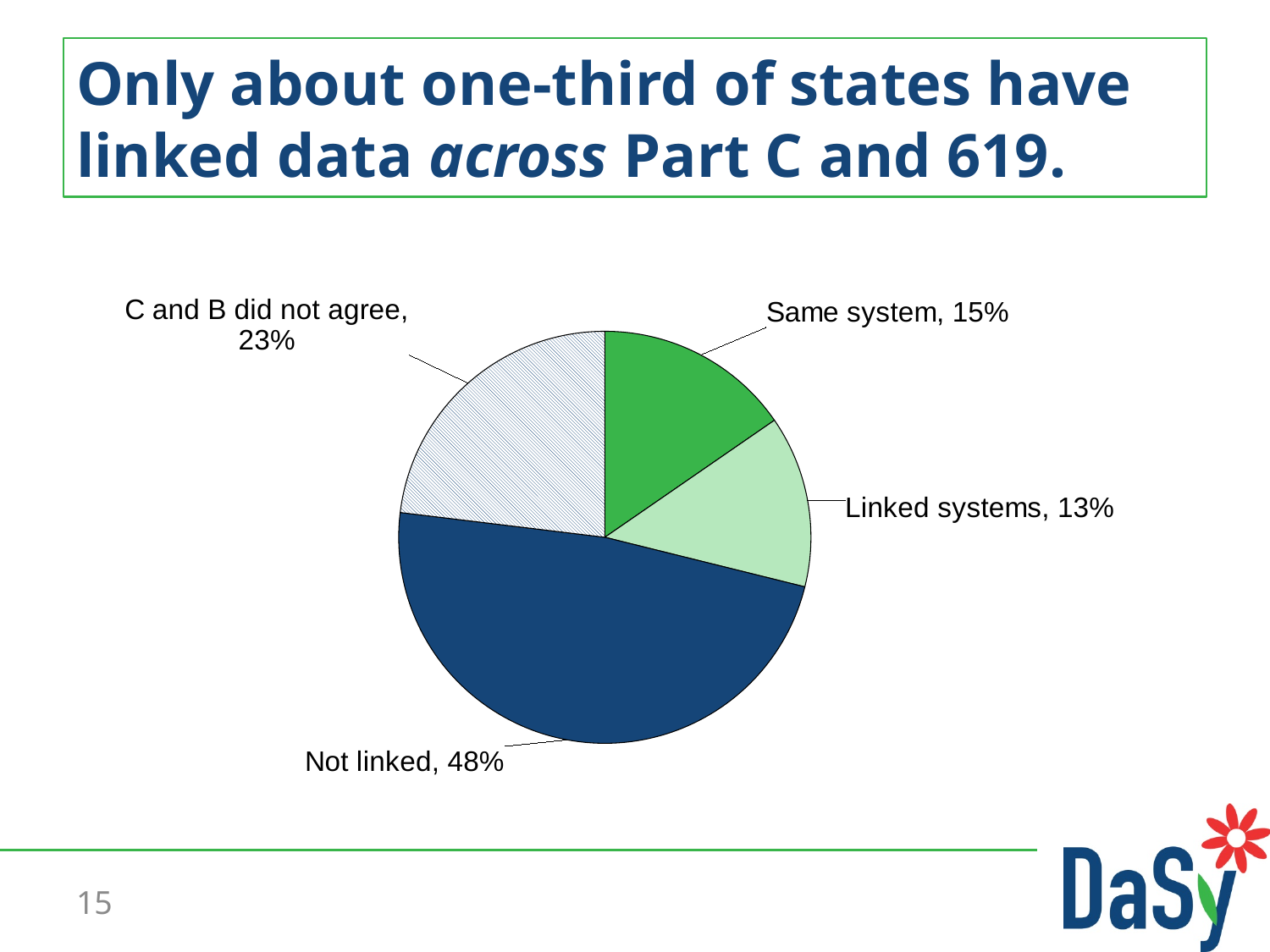
Which slice of the pie is the largest? Not linked Which is larger, the "Same system" slice or the "Linked systems" slice? Same system What is the combined share of the "Same system" and "Linked systems" slices? 28% How many slices does the pie chart have? 4 What share of the pie is labelled "C and B did not agree"? 23% What kind of chart is shown on the slide? pie chart What share of the pie is labelled "Same system"? 15% What is the difference in percentage points between the "Not linked" slice and the "C and B did not agree" slice? 25 Which slice of the pie is drawn with a hatched pattern? C and B did not agree Which slice of the pie is the smallest? Linked systems What share of the pie is labelled "Linked systems"? 13%